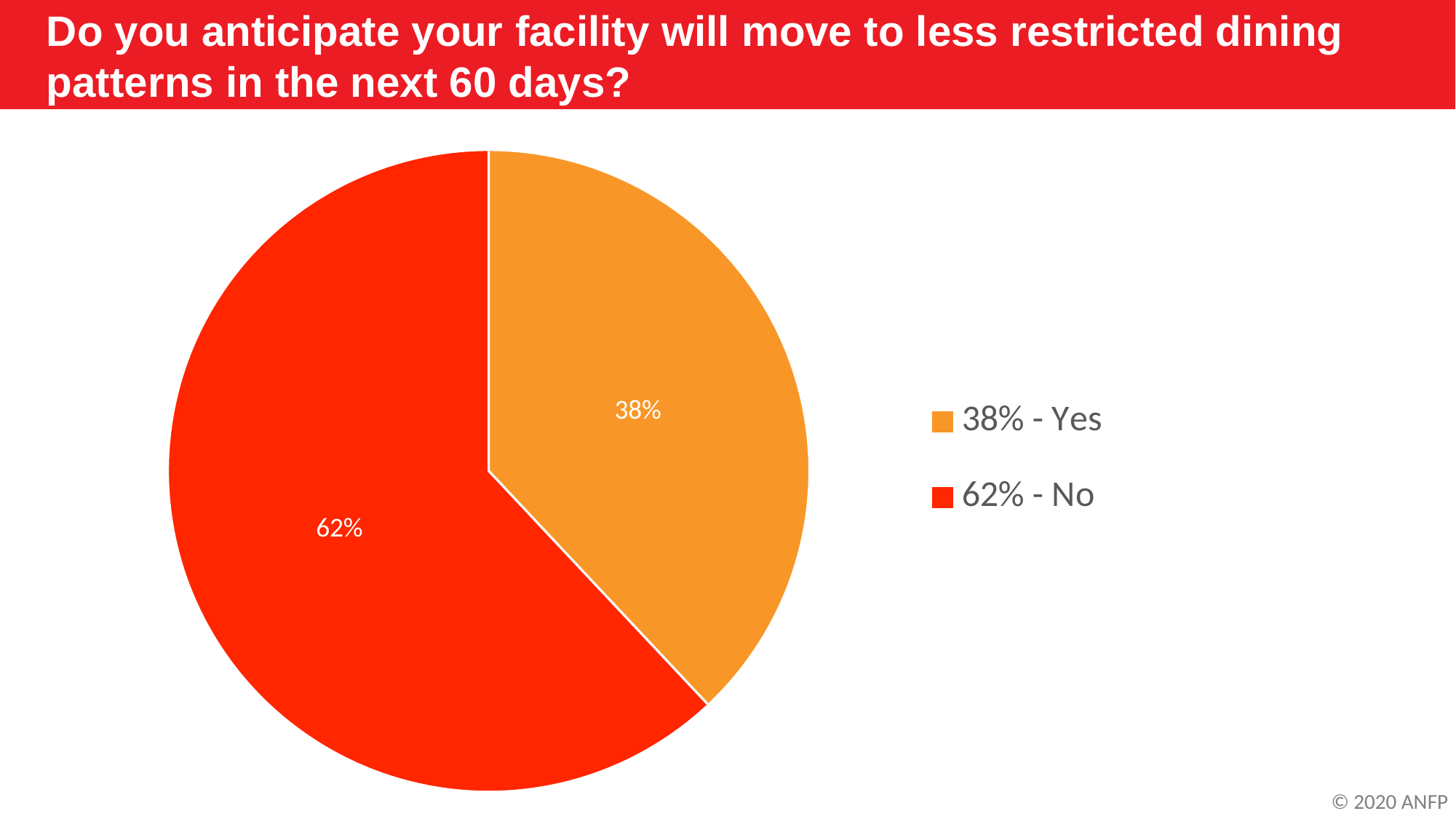
What colour is the slice representing Yes? orange What share of the pie does the No slice represent? 62% What kind of chart is shown on the slide? pie chart What is the difference in percentage points between the No and Yes responses? 24 What percentage of respondents answered Yes? 38% What is the title of the slide? Do you anticipate your facility will move to less restricted dining patterns in the next 60 days? Which is larger, the share for Yes or the share for No? No What percentage of respondents answered No? 62% Which response has the largest share of the pie? No How many entries does the legend list? 2 Which response has the smallest share of the pie? Yes How many slices does the pie chart have? 2